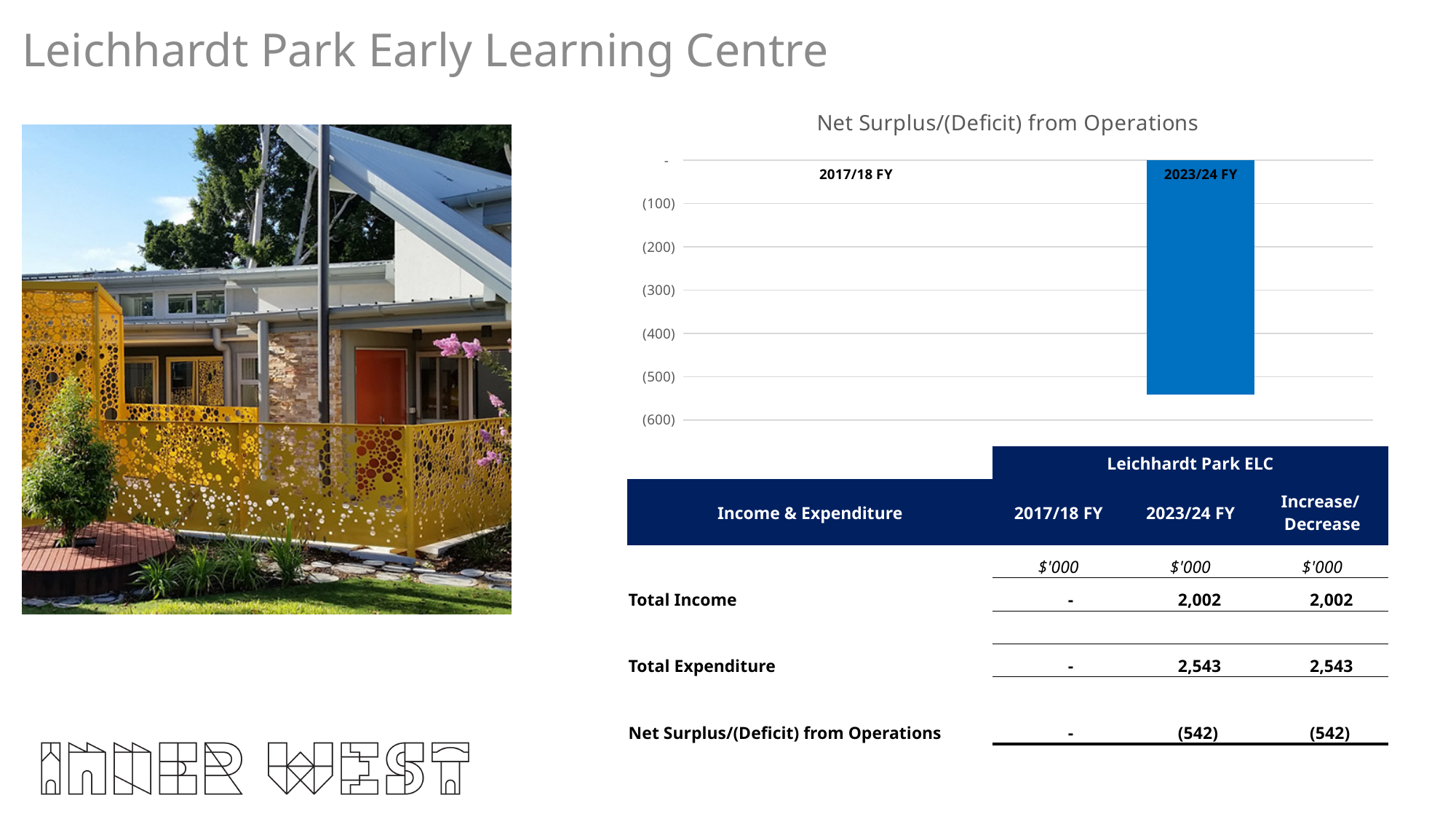
What is the Total Expenditure for 2023/24 FY shown in the table below the chart? 2,543 What is the lowest tick label shown on the vertical axis of the chart? (600) How many financial year categories are shown on the x axis of the chart? 2 Is the value for 2023/24 FY in the chart greater or less than (600)? greater Is the value for 2023/24 FY in the chart greater or less than (500)? less Which financial year has the lowest Net Surplus/(Deficit) from Operations in the chart? 2023/24 FY What is the Net Surplus/(Deficit) from Operations for 2023/24 FY, as shown in the table? (542) Do the values in the chart rise or fall from 2017/18 FY to 2023/24 FY? fall Which financial year has the higher Net Surplus/(Deficit) from Operations in the chart, 2017/18 FY or 2023/24 FY? 2017/18 FY What kind of chart is shown under the title "Net Surplus/(Deficit) from Operations"? bar chart What is the title of the chart on the slide? Net Surplus/(Deficit) from Operations Does the chart show a bar for 2017/18 FY? No